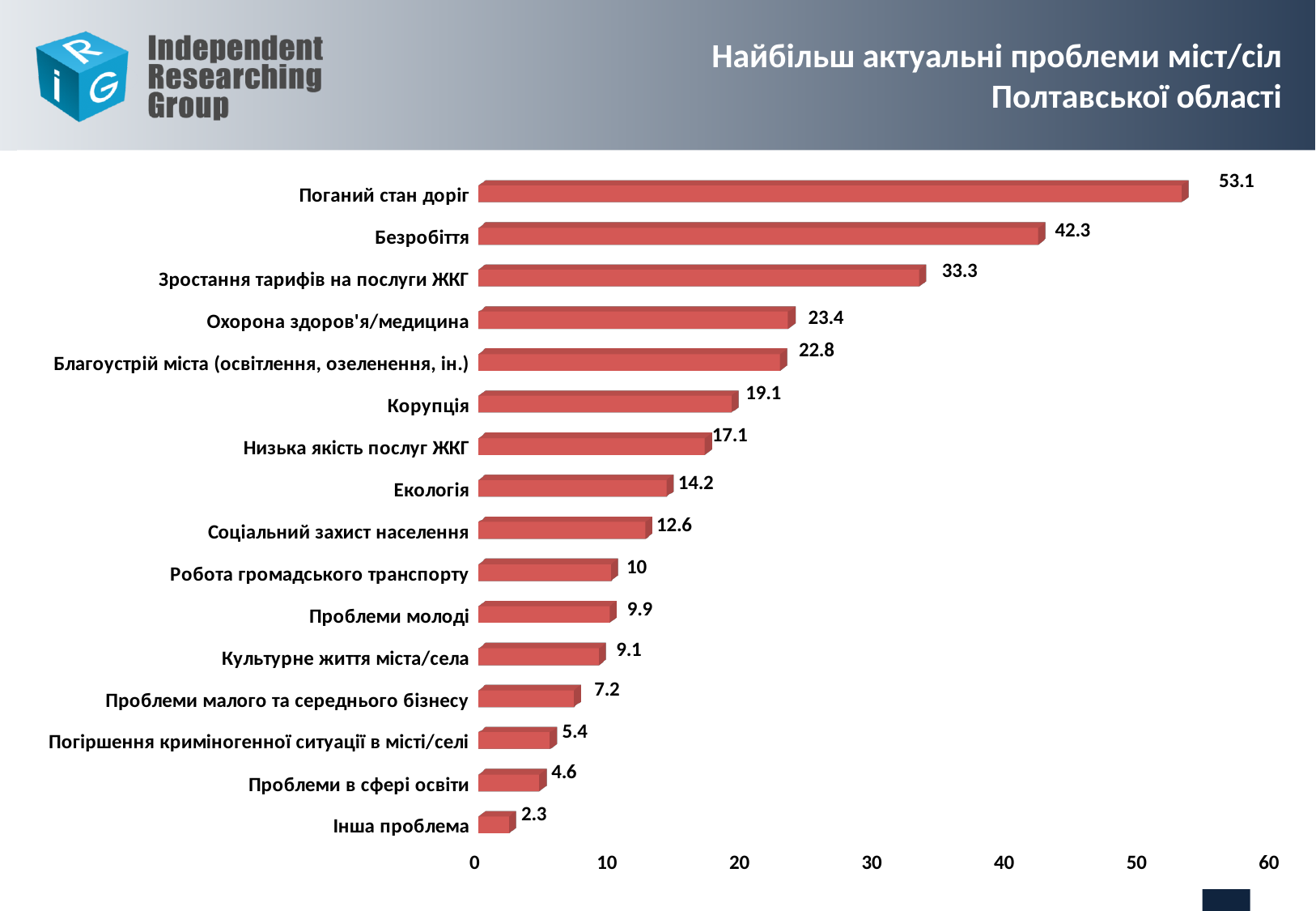
Which category has the highest value? Поганий стан доріг What is the difference between the values for Поганий стан доріг and Інша проблема? 50.8 Which is larger, the value for Екологія or the value for Соціальний захист населення? Екологія What is the title of the chart? Найбільш актуальні проблеми міст/сіл Полтавської області What is the value for Корупція? 19.1 What is the difference between the values for Безробіття and Зростання тарифів на послуги ЖКГ? 9 What kind of chart is shown on the slide? bar chart How many categories are shown in the chart? 16 Is the value for Охорона здоров'я/медицина greater or less than 20? greater What is the value for Поганий стан доріг? 53.1 What is the value for Проблеми в сфері освіти? 4.6 Which category has the lowest value? Інша проблема